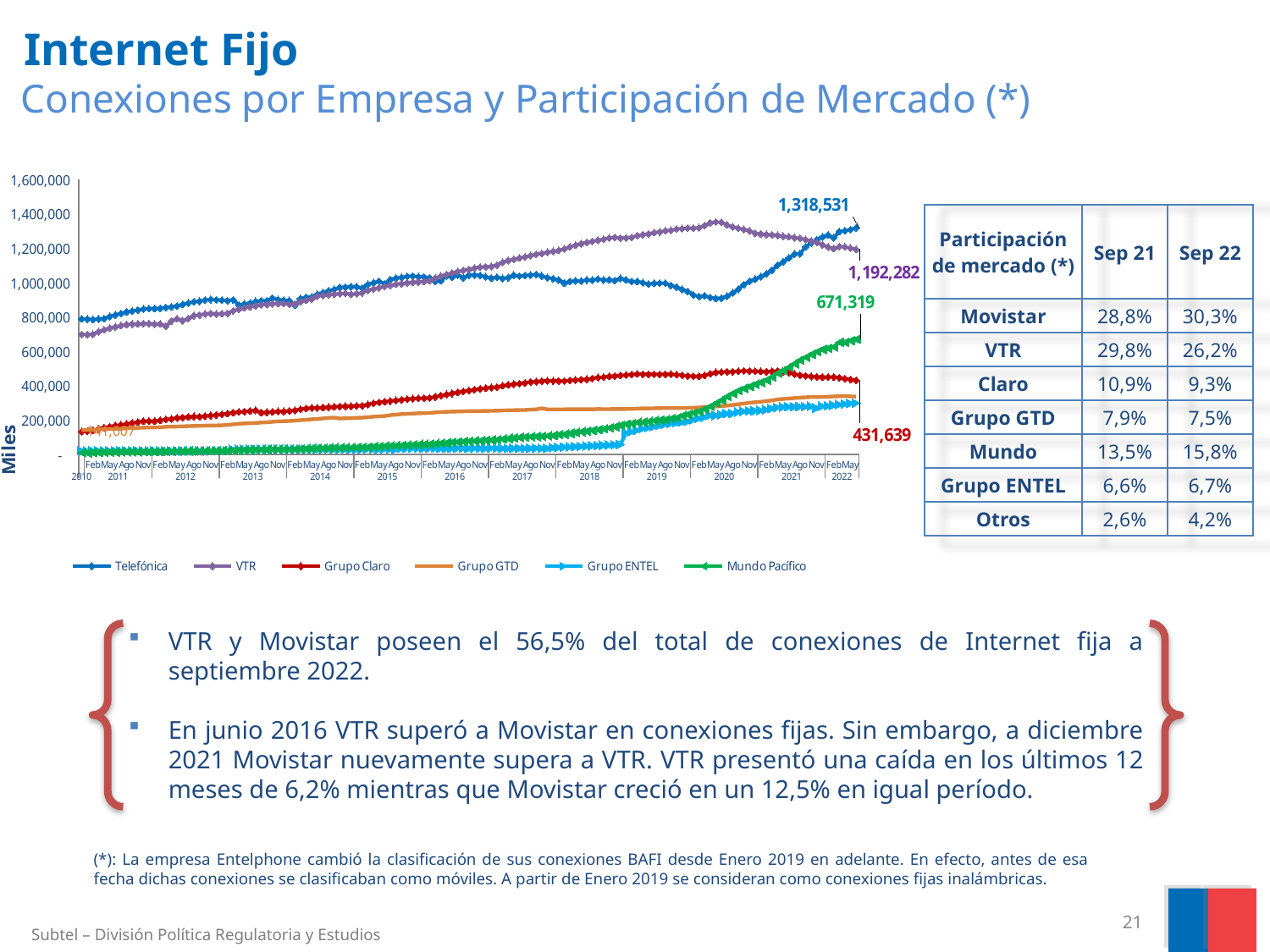
At the end of the chart, which is larger: Mundo Pacífico or Grupo Claro? Mundo Pacífico What is the final labelled value for VTR on the chart? 1,192,282 What is the final labelled value for Mundo Pacífico on the chart? 671,319 How many series does the chart legend list? 6 What is the final labelled value for Telefónica on the chart? 1,318,531 What is the difference between the final labelled values of Telefónica and VTR? 126,249 At the end of the chart, which series has the highest value? Telefónica What type of chart is shown on the slide? line chart What is the difference between the final labelled values of Mundo Pacífico and Grupo Claro? 239,680 Is the value for Grupo GTD at the end of the chart greater or less than 400,000? less Does the Mundo Pacífico series rise or fall over the period shown? rises What is the final labelled value for Grupo Claro on the chart? 431,639